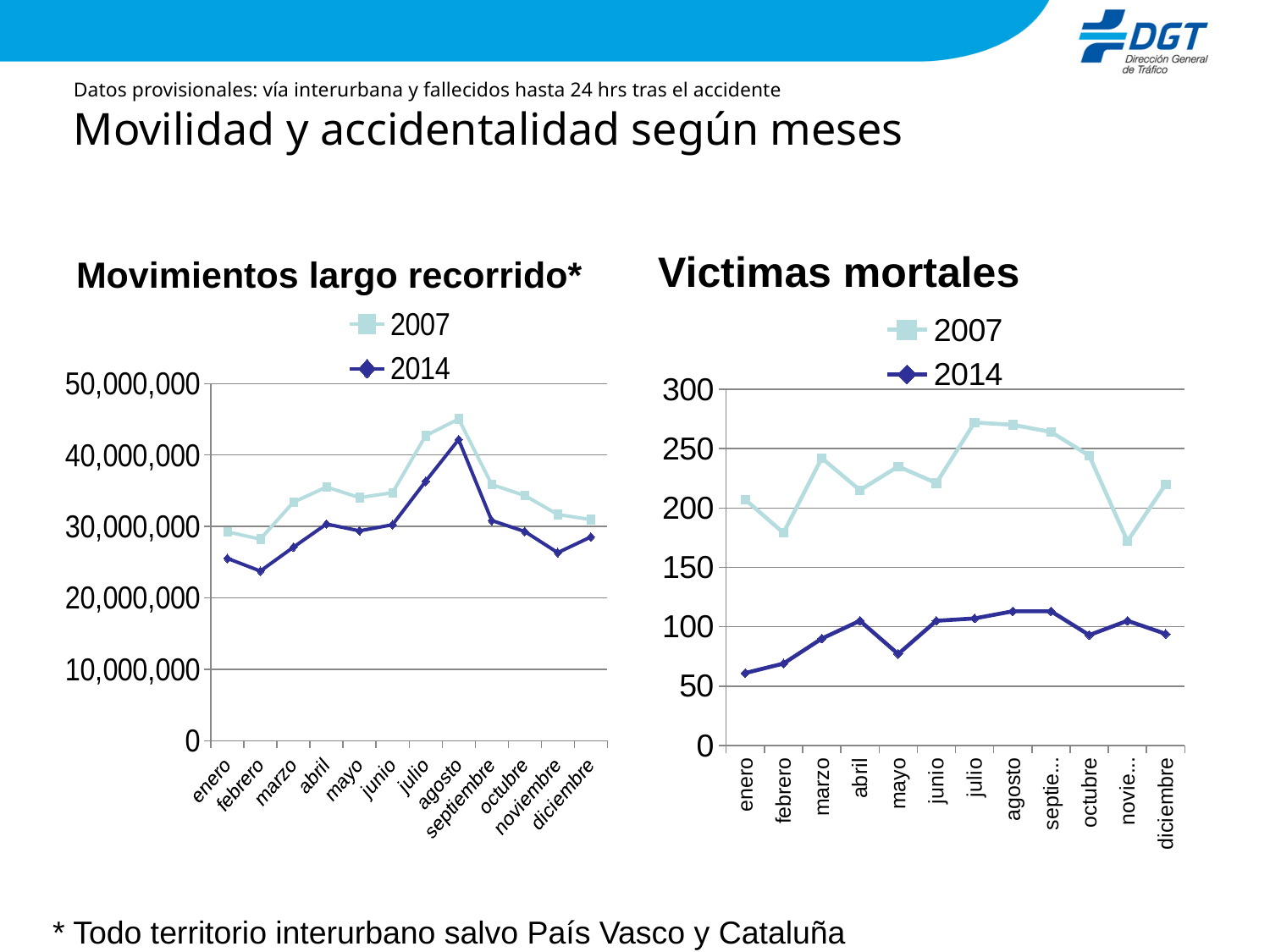
On the 'Movimientos largo recorrido*' chart, which series has the higher value in agosto, 2007 or 2014? 2007 On the 'Victimas mortales' chart, which series has the higher value in julio, 2007 or 2014? 2007 On the 'Victimas mortales' chart, how many series does the legend list? 2 On the 'Movimientos largo recorrido*' chart, in which month does the 2014 series reach its highest value? agosto On the 'Movimientos largo recorrido*' chart, is the 2014 value for febrero greater or less than 30,000,000? less On the 'Victimas mortales' chart, is the 2014 value for mayo greater or less than 100? less On the 'Victimas mortales' chart, is the 2007 value for noviembre greater or less than 200? less On the 'Victimas mortales' chart, does the 2014 series rise or fall from enero to abril? rise On the 'Victimas mortales' chart, in which month does the 2014 series have its lowest value? enero On the 'Movimientos largo recorrido*' chart, what kind of chart is it? line chart On the 'Movimientos largo recorrido*' chart, how many months are plotted along the x axis? 12